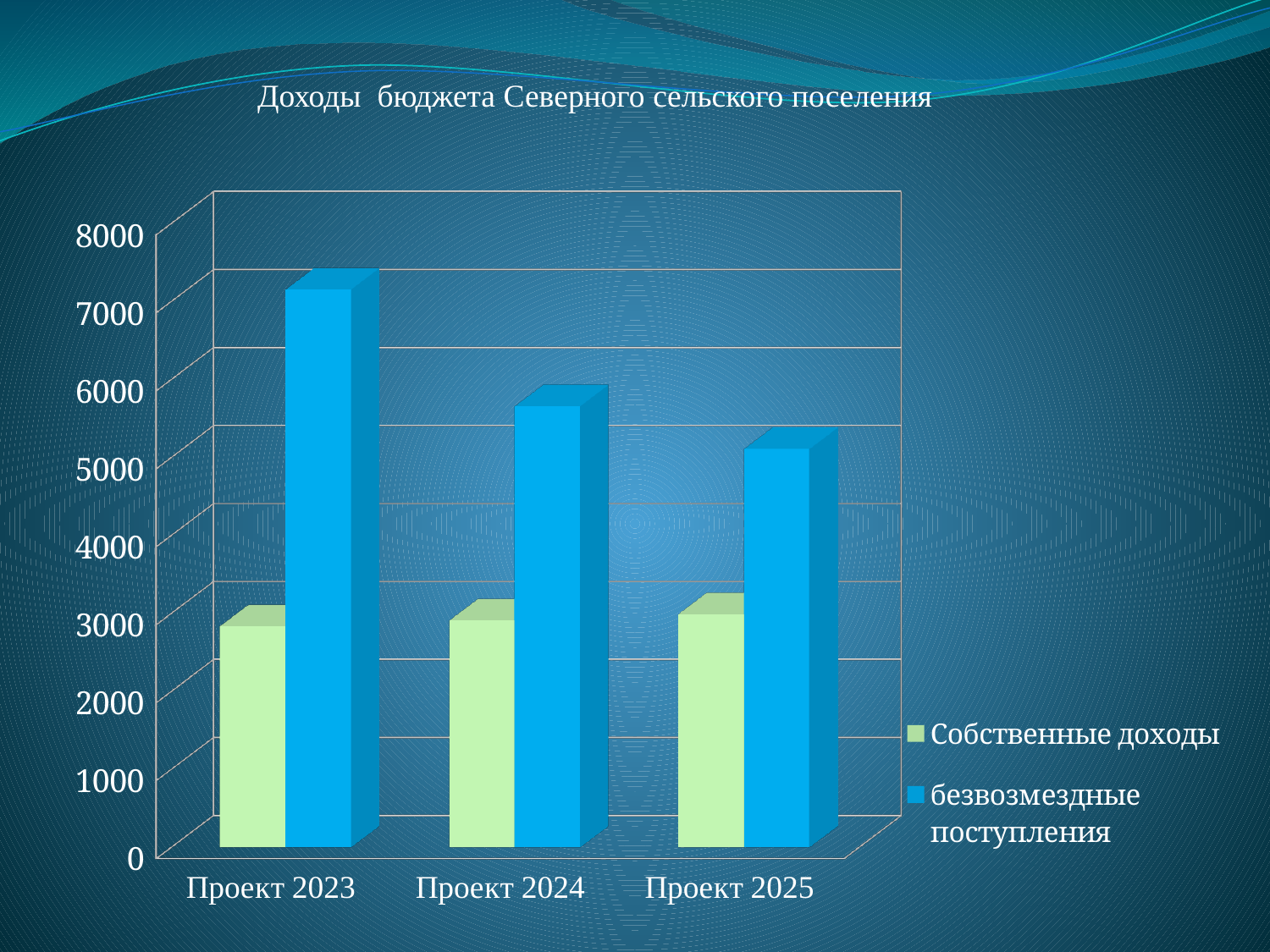
Do the values for 'безвозмездные поступления' rise or fall from Проект 2023 to Проект 2025? fall How many categories are shown on the x axis? 3 What kind of chart is shown on the slide? bar chart Which category has the highest value for 'безвозмездные поступления'? Проект 2023 Is the value for 'безвозмездные поступления' in Проект 2024 greater or less than 6000? less How many series does the legend list? 2 What is the title of the chart? Доходы бюджета Северного сельского поселения Is the value for 'Собственные доходы' in Проект 2025 greater or less than 4000? less Is the value for 'безвозмездные поступления' in Проект 2023 greater or less than 7000? greater In Проект 2024, which is larger: 'Собственные доходы' or 'безвозмездные поступления'? безвозмездные поступления Which category has the lowest value for 'безвозмездные поступления'? Проект 2025 Which colour represents the series 'безвозмездные поступления'? blue